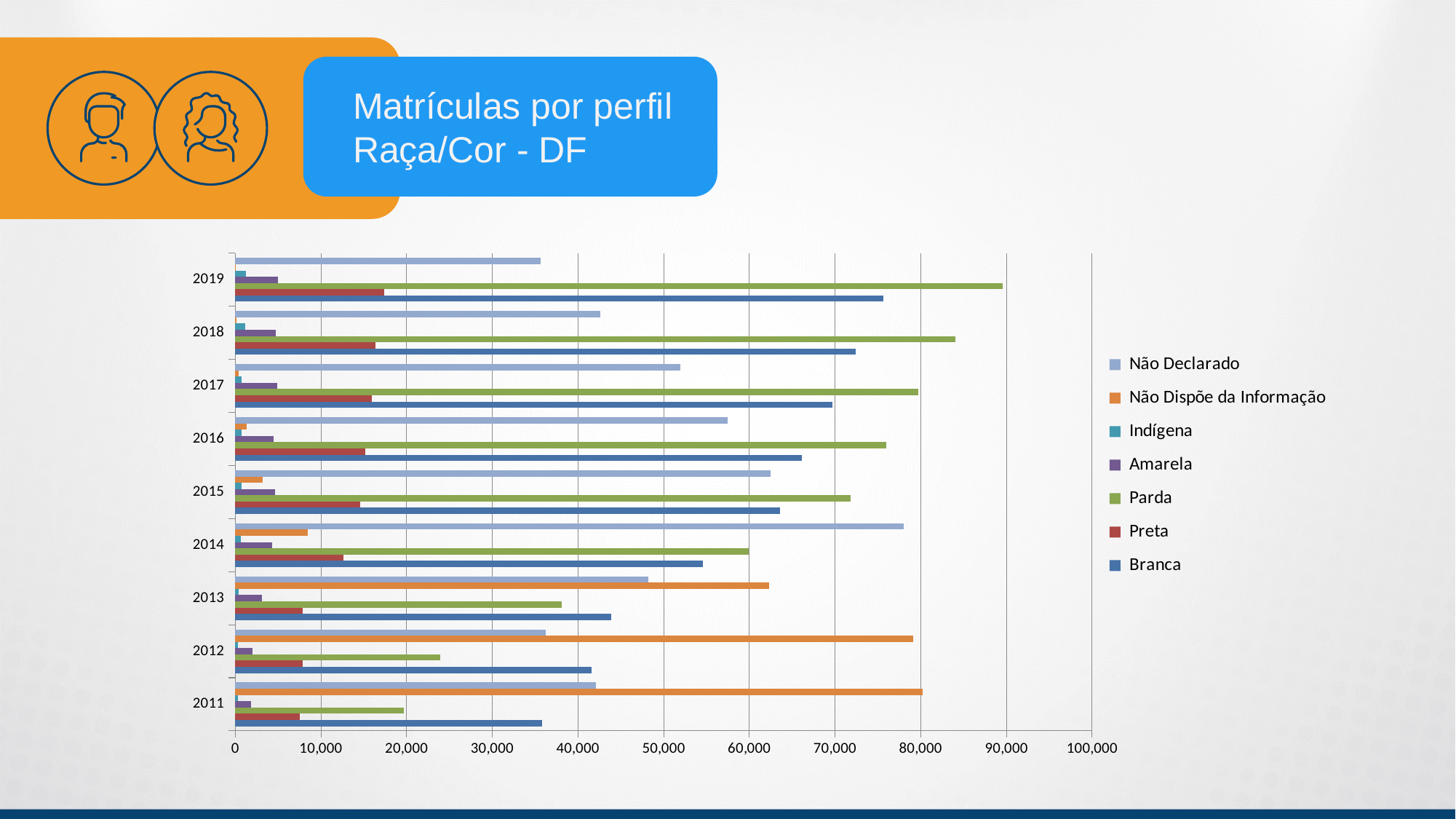
Is the value for Parda in 2019 greater or less than 80,000? greater In 2019, which is larger: Parda or Branca? Parda In which year is the Parda value highest? 2019 What is the title of the slide? Matrículas por perfil Raça/Cor - DF In which year is the Parda value lowest? 2011 What kind of chart is shown on the slide? bar chart How many series does the legend list? 7 How many years are shown on the vertical axis of the chart? 9 Is the value for Não Declarado in 2014 greater or less than 70,000? greater Is the value for Branca in 2011 greater or less than 40,000? less In 2011, which is larger: Não Dispõe da Informação or Não Declarado? Não Dispõe da Informação Does the value for Não Dispõe da Informação rise or fall from 2011 to 2019? fall